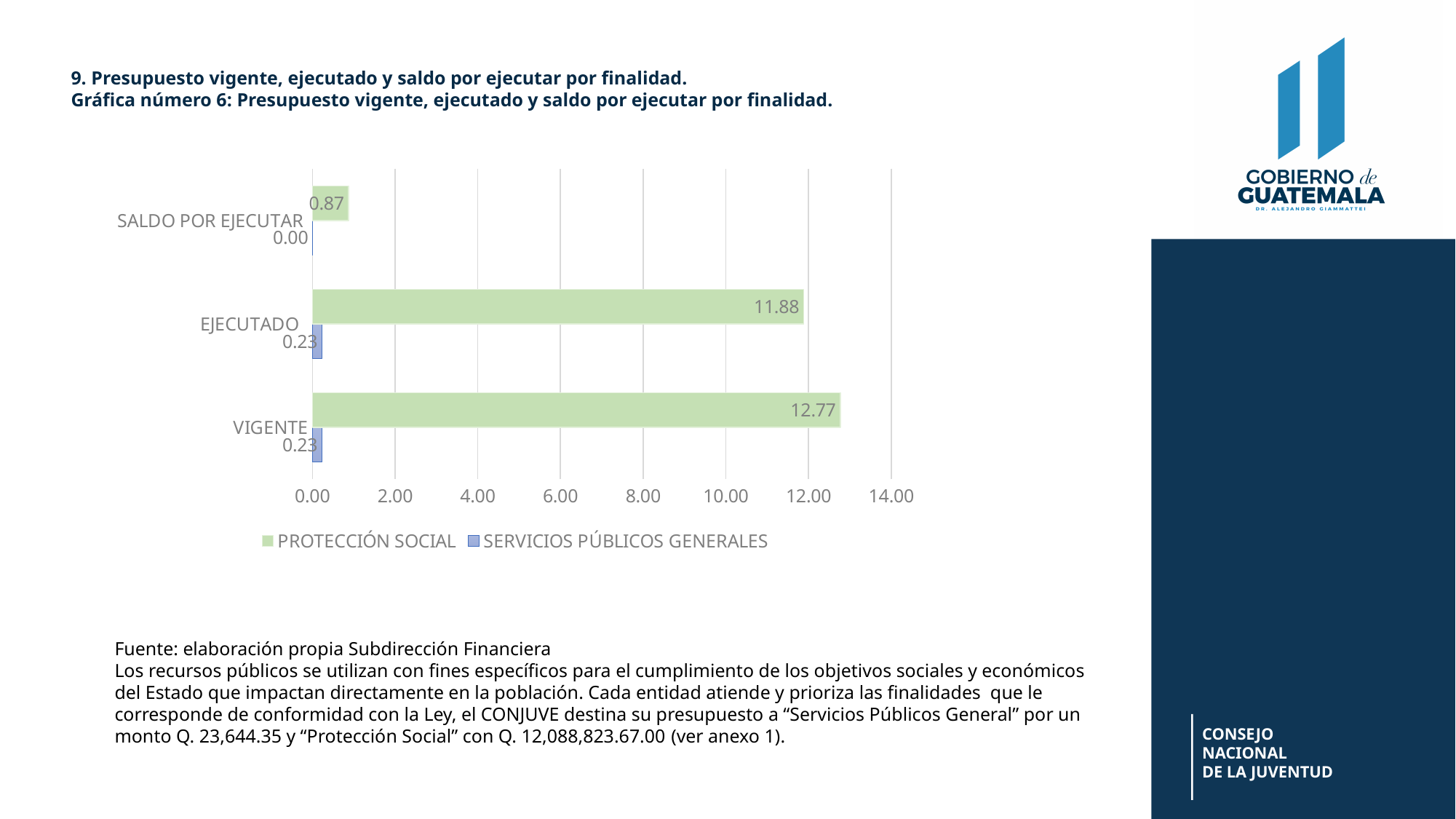
What is the difference between the PROTECCIÓN SOCIAL values for VIGENTE and EJECUTADO? 0.89 What is the value for PROTECCIÓN SOCIAL in the EJECUTADO category? 11.88 What is the value for SERVICIOS PÚBLICOS GENERALES in the SALDO POR EJECUTAR category? 0.00 What kind of chart is shown on the slide? Bar chart How many categories are shown on the chart? 3 Which is larger: the PROTECCIÓN SOCIAL value for EJECUTADO or for SALDO POR EJECUTAR? EJECUTADO What is the value for PROTECCIÓN SOCIAL in the VIGENTE category? 12.77 How many series does the legend list? 2 Which category has the lowest value for PROTECCIÓN SOCIAL? SALDO POR EJECUTAR What is the value for SERVICIOS PÚBLICOS GENERALES in the VIGENTE category? 0.23 What is the value for PROTECCIÓN SOCIAL in the SALDO POR EJECUTAR category? 0.87 Which category has the highest value for PROTECCIÓN SOCIAL? VIGENTE